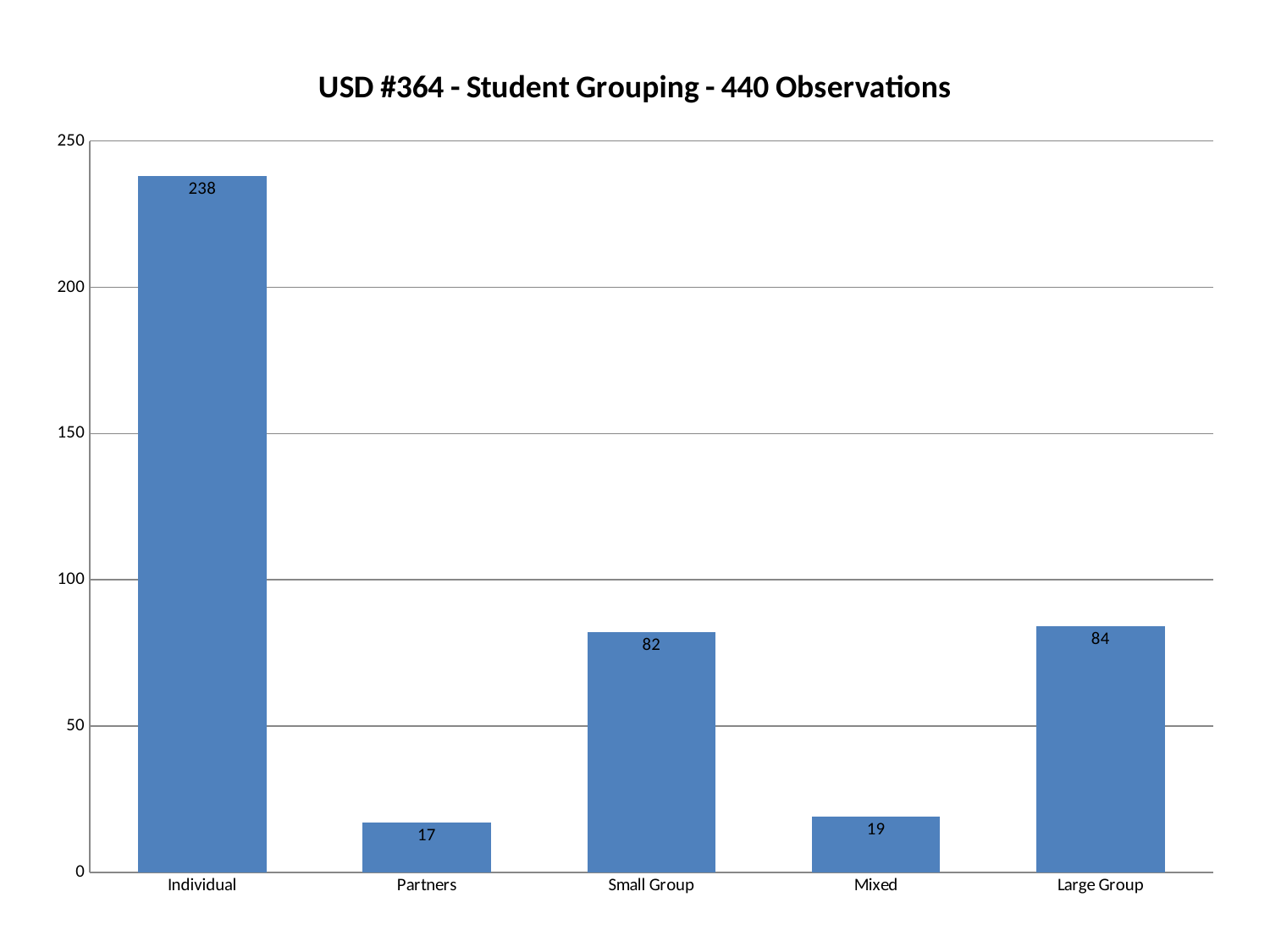
Which is larger, the value for Small Group or the value for Mixed? Small Group Which category has the lowest value? Partners What is the difference between the values for Individual and Large Group? 154 What is the value for Large Group? 84 What is the value for Small Group? 82 Which category has the highest value? Individual What is the title of the chart? USD #364 - Student Grouping - 440 Observations What kind of chart is this? Bar chart What is the value for Partners? 17 How many categories are shown on the x axis? 5 What is the value for Individual? 238 What is the value for Mixed? 19